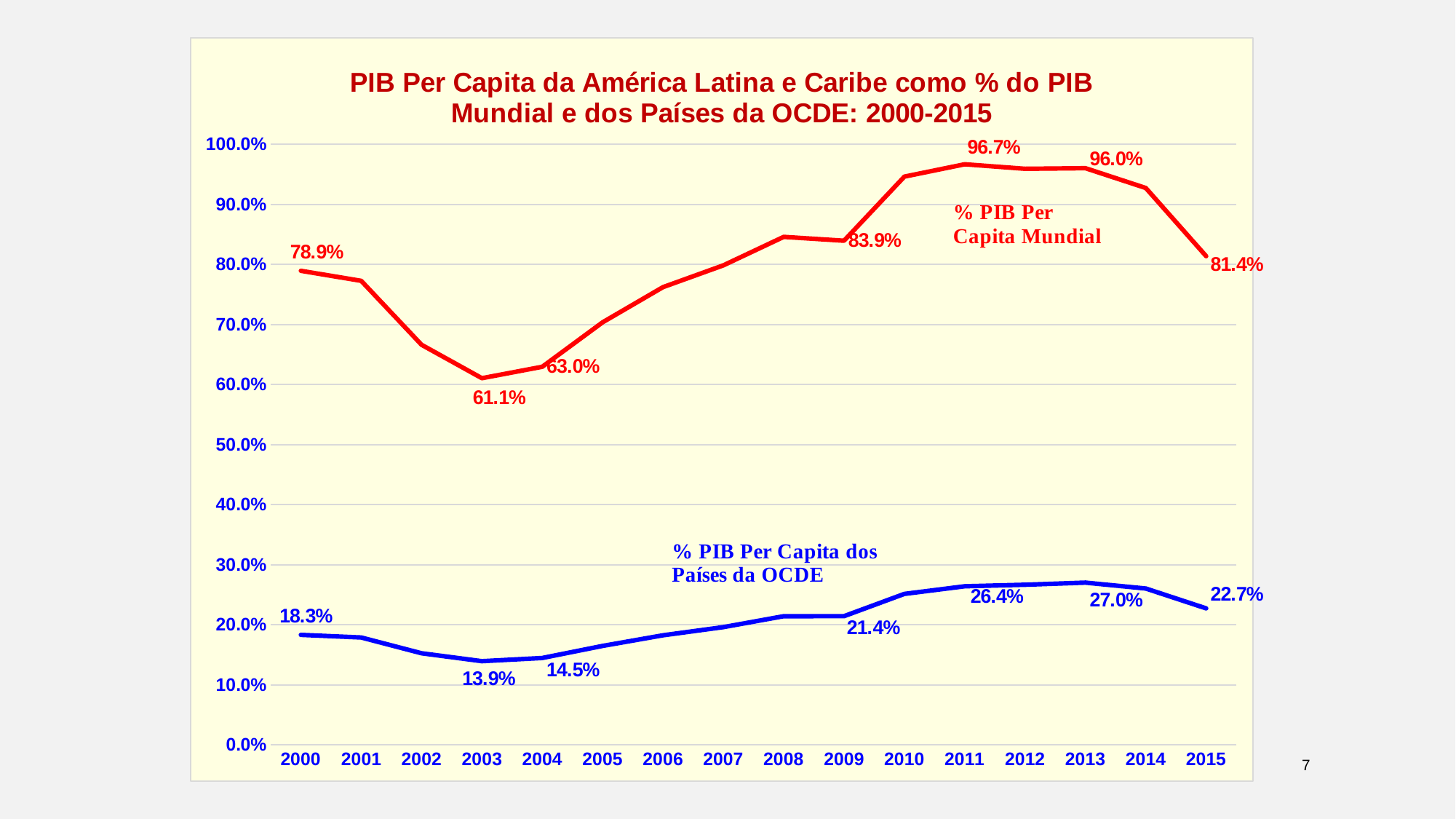
How many years are shown on the x axis? 16 What is the value of the % PIB Per Capita dos Países da OCDE series in 2015? 22.7% Does the % PIB Per Capita Mundial series rise or fall between 2003 and 2011? Rises What is the difference between the % PIB Per Capita dos Países da OCDE values in 2013 and 2000? 8.7 percentage points What is the value of the % PIB Per Capita Mundial series in 2000? 78.9% In which year does the % PIB Per Capita Mundial series reach its highest labelled value? 2011 In which year does the % PIB Per Capita dos Países da OCDE series reach its lowest value? 2003 Is the value of the % PIB Per Capita Mundial series in 2006 greater or less than 70.0%? greater Which is larger for the % PIB Per Capita dos Países da OCDE series: the value in 2011 or in 2013? 2013 What type of chart is shown on the slide? Line chart What is the value of the % PIB Per Capita Mundial series in 2009? 83.9% What is the difference between the % PIB Per Capita Mundial values in 2011 and 2000? 17.8 percentage points